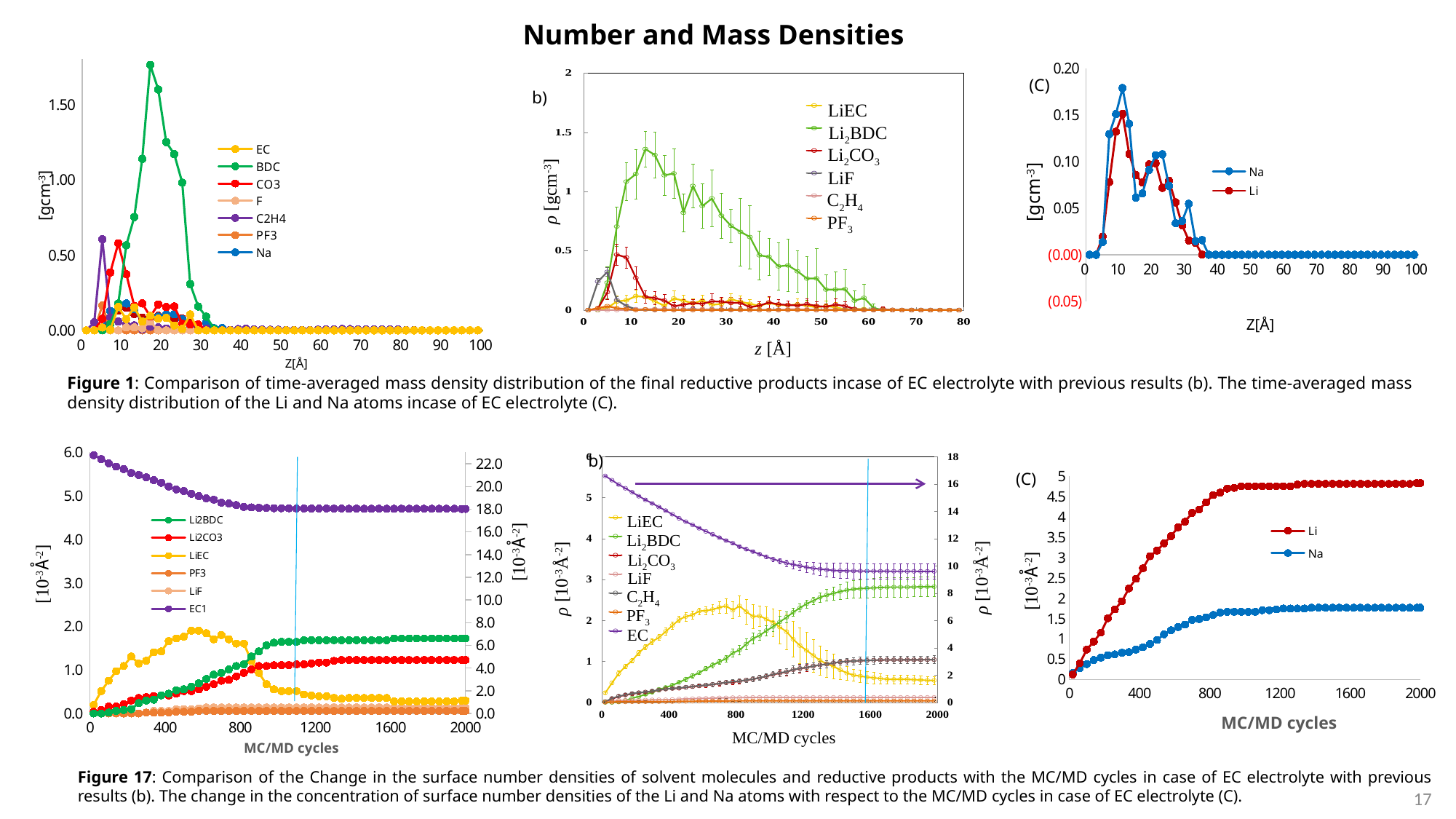
In the top-left chart (mass density vs Z[Å]), is the peak value of BDC greater or less than 1.50? greater In the top-middle chart labelled b) (ρ vs z [Å]), how many series does the legend list? 6 In the bottom-right chart labelled (C) (Li and Na vs MC/MD cycles), which series reaches the higher value at 2000 cycles, Li or Na? Li In the bottom-right chart labelled (C) (Li and Na vs MC/MD cycles), is the value of Na at 2000 cycles greater or less than 2? less In the bottom-left chart (surface number densities vs MC/MD cycles), what kind of chart is it? line chart In the bottom-left chart (surface number densities vs MC/MD cycles), does the EC1 series rise or fall as MC/MD cycles increase? fall In the top-right chart labelled (C) (Na and Li vs Z[Å]), which series reaches the higher peak, Na or Li? Na In the top-left chart (mass density vs Z[Å]), which series reaches the highest peak? BDC In the top-middle chart labelled b) (ρ vs z [Å]), which series reaches the highest peak? Li2BDC In the bottom-middle chart labelled b) (ρ vs MC/MD cycles), how many series does the legend list? 7 In the top-left chart (mass density vs Z[Å]), how many series does the legend list? 7 In the top-right chart labelled (C) (Na and Li vs Z[Å]), is the peak value of Na greater or less than 0.15? greater